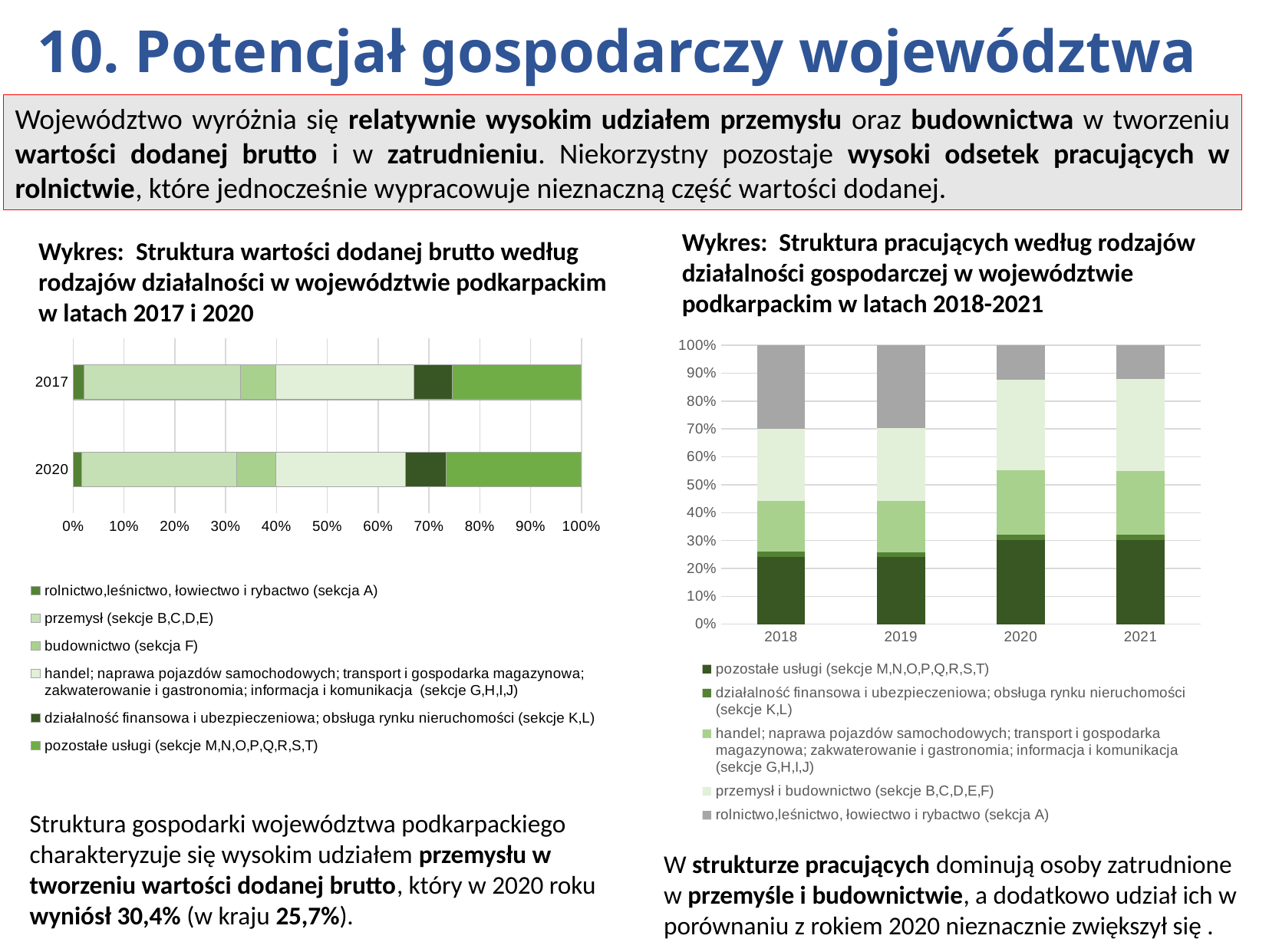
In the right chart (struktura pracujących), is the share of 'rolnictwo, leśnictwo, łowiectwo i rybactwo (sekcja A)' in 2018 greater or less than 20%? greater In the right chart (struktura pracujących), is the share of 'rolnictwo, leśnictwo, łowiectwo i rybactwo (sekcja A)' larger in 2018 or in 2021? 2018 In the left chart (wartości dodanej brutto), is the share of 'rolnictwo, leśnictwo, łowiectwo i rybactwo (sekcja A)' in 2017 greater or less than 10%? less How many series does the legend of the right chart (struktura pracujących) list? 5 What kind of chart is the right chart, 'Struktura pracujących według rodzajów działalności gospodarczej w województwie podkarpackim w latach 2018-2021'? Stacked bar chart In the right chart (struktura pracujących), is the share of 'pozostałe usługi (sekcje M,N,O,P,Q,R,S,T)' in 2018 greater or less than 30%? less In the right chart (struktura pracujących), does the share of 'rolnictwo, leśnictwo, łowiectwo i rybactwo (sekcja A)' rise or fall from 2018 to 2021? fall In the left chart (wartości dodanej brutto), which is larger in 2017: the share of 'przemysł (sekcje B,C,D,E)' or 'budownictwo (sekcja F)'? przemysł (sekcje B,C,D,E) What kind of chart is the left chart, 'Struktura wartości dodanej brutto według rodzajów działalności w województwie podkarpackim w latach 2017 i 2020'? Stacked bar chart How many series does the legend of the left chart (wartości dodanej brutto) list? 6 How many years are shown as bars in the right chart (struktura pracujących)? 4 How many years are shown as bars in the left chart (wartości dodanej brutto)? 2